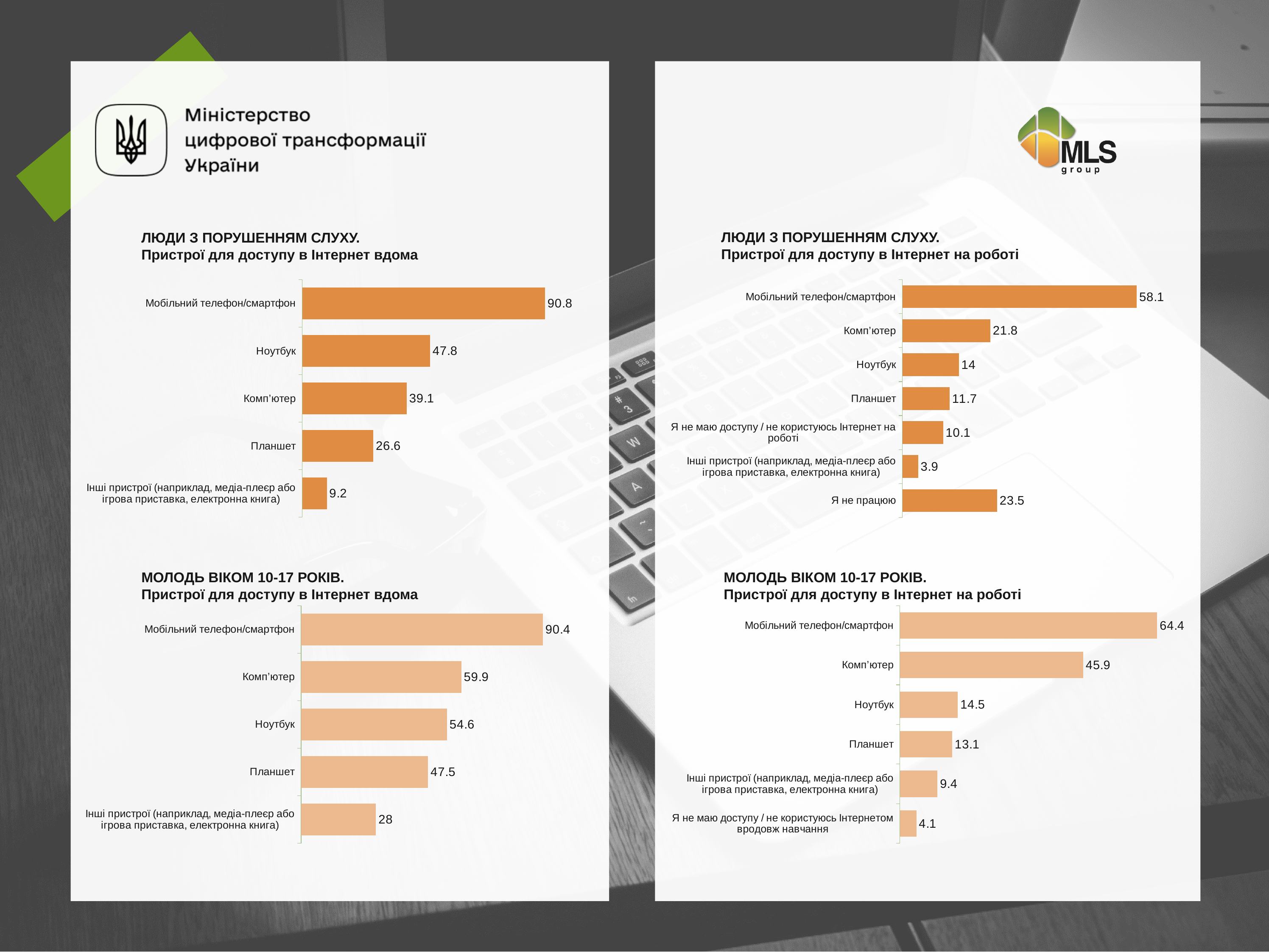
In the top-left chart (Люди з порушенням слуху, вдома), which category has the lowest value? Інші пристрої (наприклад, медіа-плеєр або ігрова приставка, електронна книга) In the top-right chart (Люди з порушенням слуху, на роботі), what is the difference between Мобільний телефон/смартфон and Комп'ютер? 36.3 In the bottom-left chart (Молодь віком 10-17 років, вдома), which is larger: Комп'ютер or Ноутбук? Комп'ютер What type of chart is the top-left chart (Люди з порушенням слуху, вдома)? Bar chart In the top-left chart (Люди з порушенням слуху, вдома), what is the value for Ноутбук? 47.8 In the bottom-right chart (Молодь віком 10-17 років, на роботі), what is the value for Інші пристрої? 9.4 In the bottom-left chart (Молодь віком 10-17 років, вдома), which category has the highest value? Мобільний телефон/смартфон In the bottom-right chart (Молодь віком 10-17 років, на роботі), how many categories are shown? 6 In the top-right chart (Люди з порушенням слуху, на роботі), what is the value for Я не працюю? 23.5 In the top-right chart (Люди з порушенням слуху, на роботі), how many categories are shown? 7 In the bottom-left chart (Молодь віком 10-17 років, вдома), what is the value for Планшет? 47.5 In the bottom-right chart (Молодь віком 10-17 років, на роботі), what is the difference between Ноутбук and Планшет? 1.4